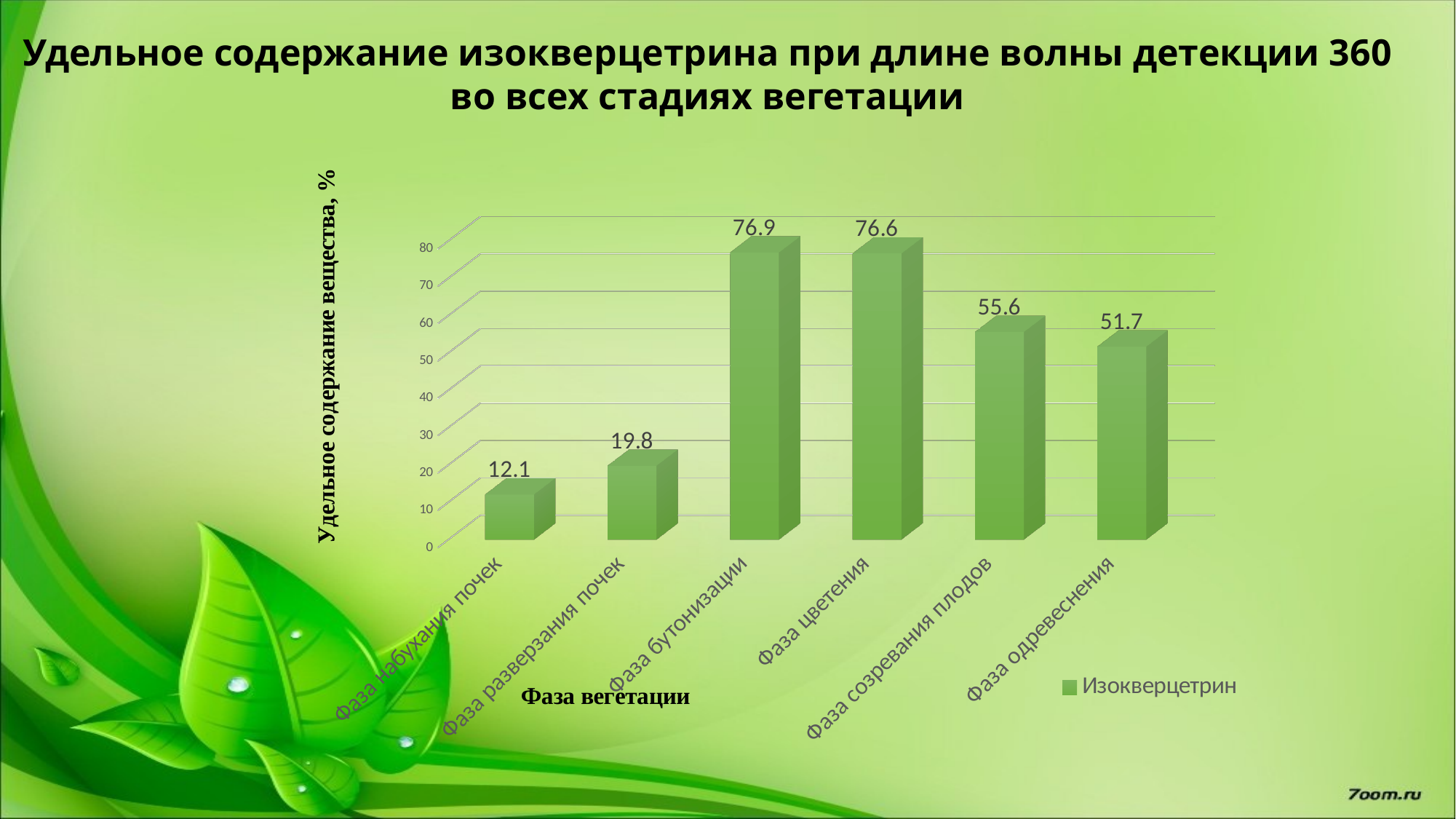
What is the value for Фаза бутонизации? 76.9 Which vegetation phase has the highest value? Фаза бутонизации What is the difference between the values for Фаза разверзания почек and Фаза набухания почек? 7.7 Which is larger, the value for Фаза цветения or the value for Фаза созревания плодов? Фаза цветения How many vegetation phases are shown on the x axis? 6 Which vegetation phase has the lowest value? Фаза набухания почек What series name is listed in the legend? Изокверцетрин What is the value for Фаза одревеснения? 51.7 What is the value for Фаза набухания почек? 12.1 What is the difference between the values for Фаза созревания плодов and Фаза одревеснения? 3.9 What kind of chart is shown on the slide? Bar chart What is the value for Фаза созревания плодов? 55.6